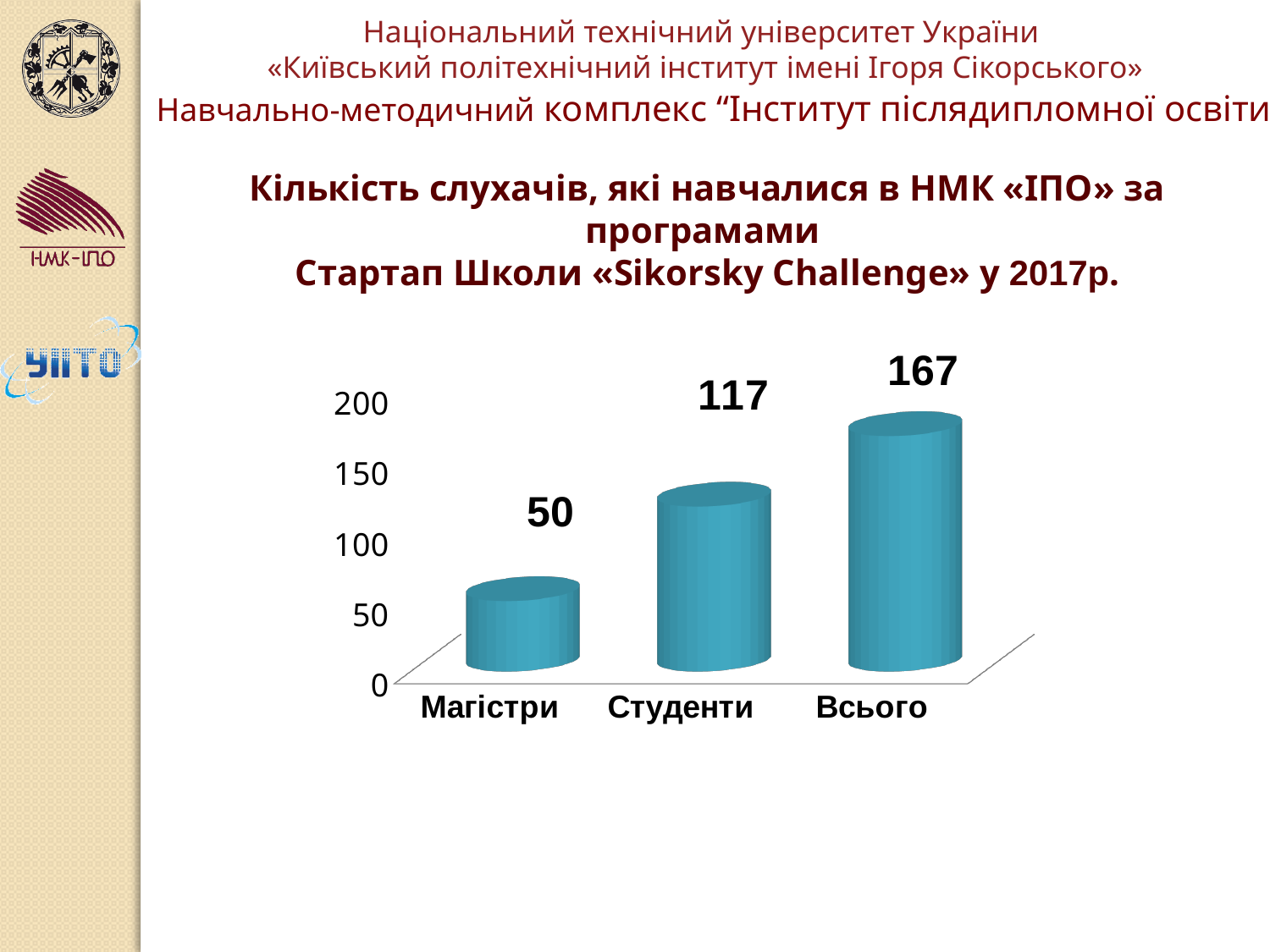
What is the difference between the values for Студенти and Магістри? 67 What is the highest tick value shown on the vertical axis? 200 Which is larger, the value for Студенти or the value for Магістри? Студенти Do the values rise or fall from left to right along the x axis? rise Is the value for Всього greater or less than 150? greater What is the value for Студенти? 117 What kind of chart is shown on the slide? bar chart Which category has the lowest value? Магістри Which category has the highest value? Всього What is the value for Всього? 167 What is the value for Магістри? 50 How many categories are shown on the x axis? 3